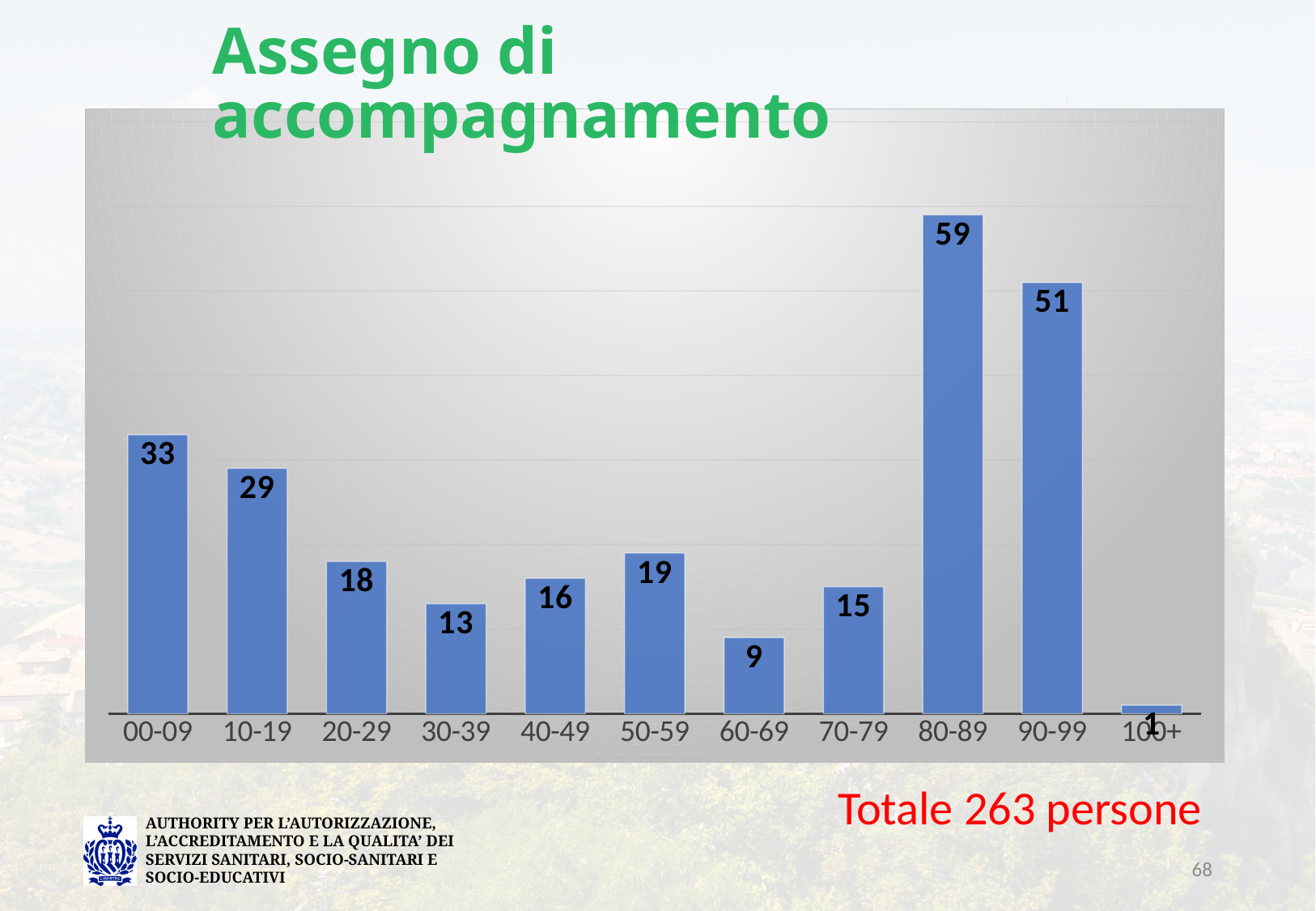
What is the value for the 80-89 age group? 59 Which age group has the highest value? 80-89 How many age groups are shown on the x axis? 11 What is the value for the 00-09 age group? 33 Do the values rise or fall from 00-09 to 30-39? fall What is the difference between the values for 80-89 and 90-99? 8 What is the title of the slide above the chart? Assegno di accompagnamento Which age group has the lowest value? 100+ What kind of chart is shown on the slide? bar chart What is the value for the 30-39 age group? 13 Which is larger, the value for 50-59 or the value for 70-79? 50-59 What is the difference between the values for 00-09 and 60-69? 24